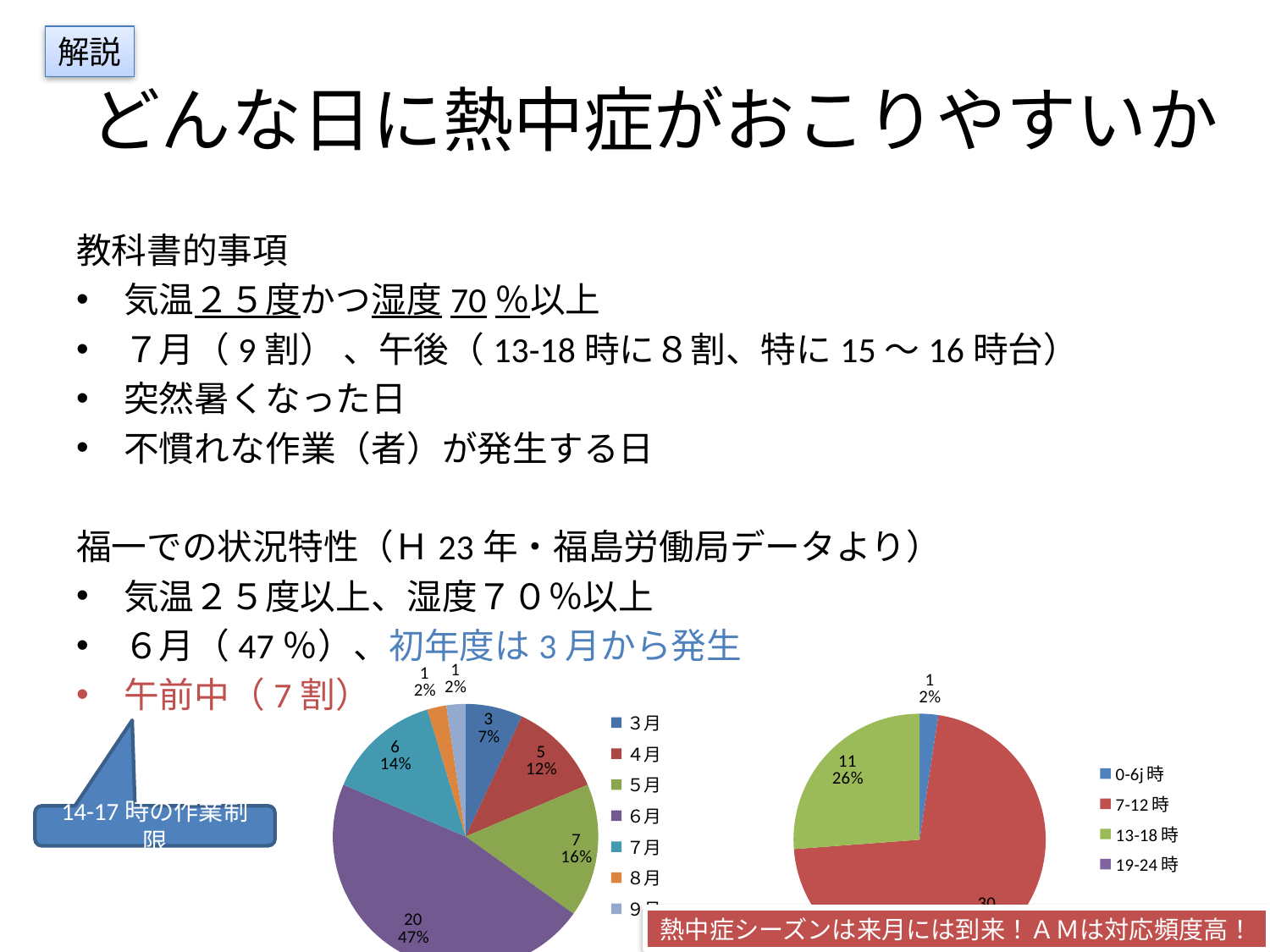
In the right pie chart (by time of day), which category has the largest slice? 7-12時 What kind of chart is the left chart on the slide? pie chart In the left pie chart (by month), what is the difference between the values for 6月 and 4月? 15 In the left pie chart (by month), which month has the largest slice? 6月 In the left pie chart (by month), what percentage share does 3月 have? 7% In the left pie chart (by month), what percentage share does 6月 have? 47% How many entries does the legend of the right pie chart (by time of day) list? 4 In the right pie chart (by time of day), what percentage share does 13-18時 have? 26% In the left pie chart (by month), which is larger, the value for 4月 or the value for 7月? 7月 In the right pie chart (by time of day), what is the value for 0-6j時? 1 In the left pie chart (by month), what is the value for 7月? 6 In the left pie chart (by month), what is the value for 5月? 7